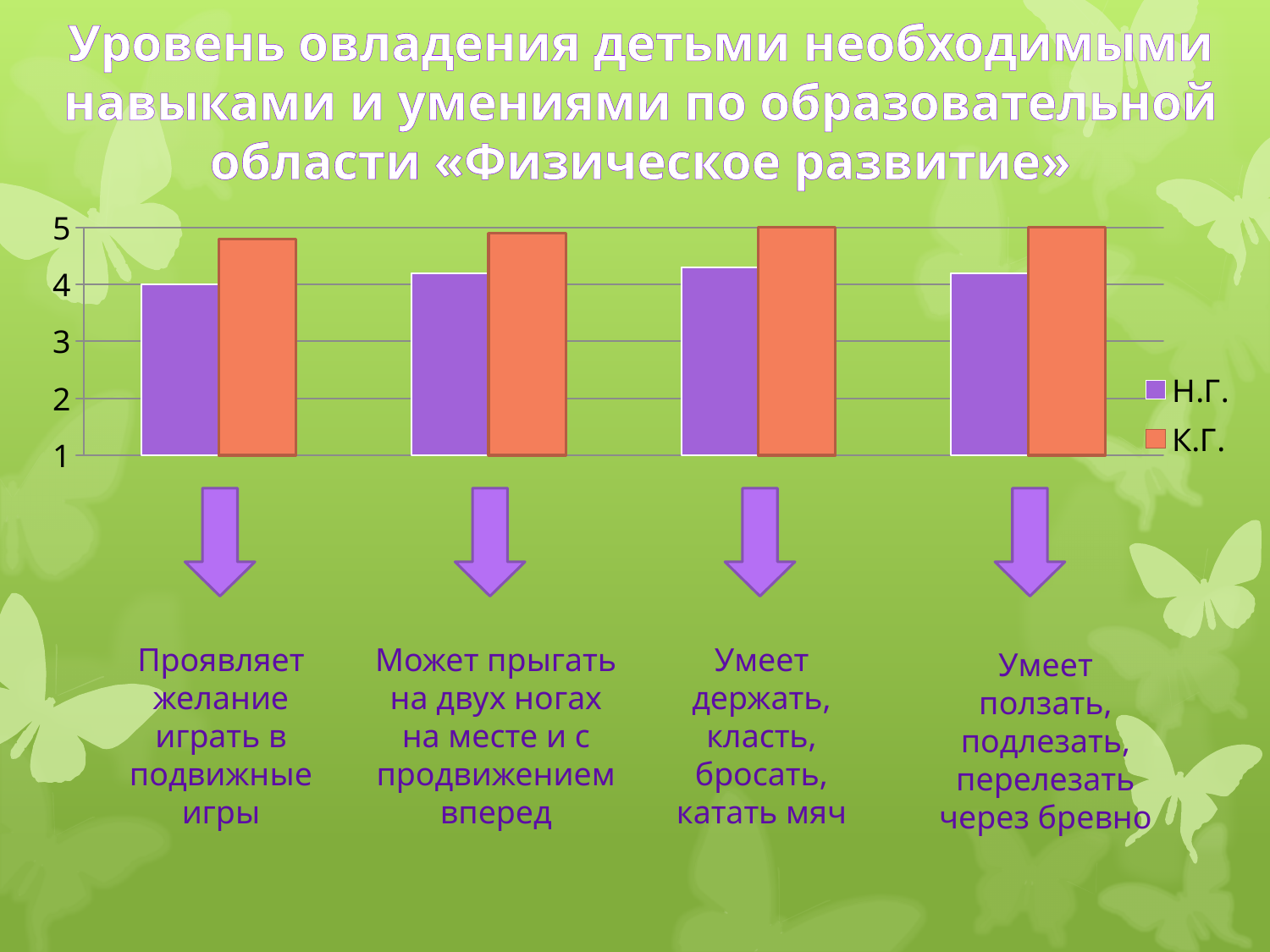
Is the Н.Г. value for «Может прыгать на двух ногах на месте и с продвижением вперед» greater or less than 5? less In every category, is the К.Г. bar higher or lower than the Н.Г. bar? higher What are the two series named in the legend? Н.Г. and К.Г. For the category «Умеет держать, класть, бросать, катать мяч», which series has the larger value, Н.Г. or К.Г.? К.Г. Is the К.Г. value for «Проявляет желание играть в подвижные игры» greater or less than 4? greater How many series does the legend list? 2 Which series is shown in orange in the legend? К.Г. What is the К.Г. value for «Умеет держать, класть, бросать, катать мяч»? 5 For the category «Проявляет желание играть в подвижные игры», which series has the smaller value, Н.Г. or К.Г.? Н.Г. How many categories (groups of bars) are plotted in the chart? 4 What kind of chart is shown on the slide? bar chart Is the К.Г. value for «Умеет ползать, подлезать, перелезать через бревно» greater or less than 4? greater